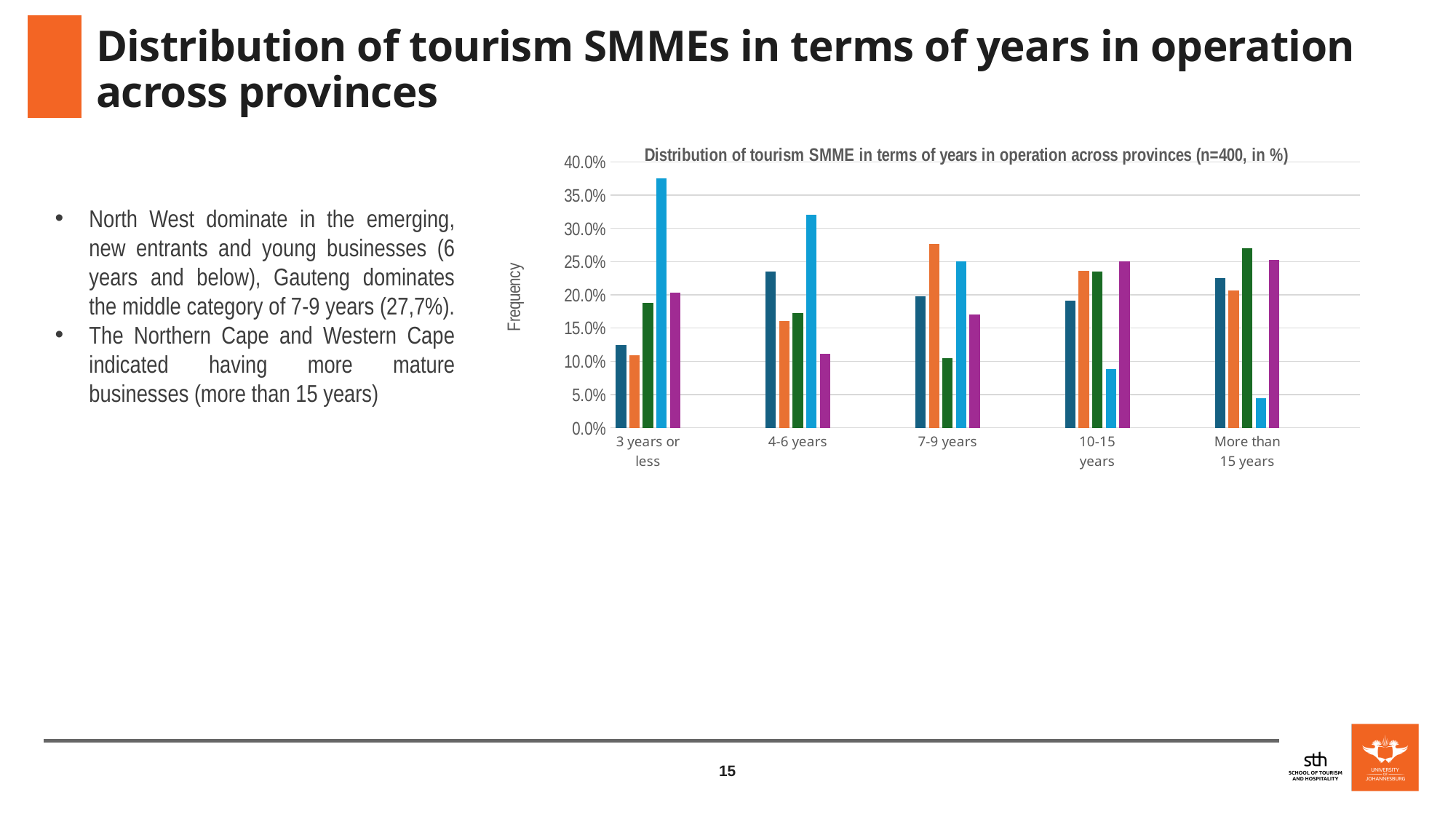
Is the value of the light blue bar for 'More than 15 years' greater or less than 5%? less What kind of chart is shown on the slide? bar chart What is the title of the chart? Distribution of tourism SMME in terms of years in operation across provinces (n=400, in %) Is the value of the dark green bar for '7-9 years' greater or less than 15%? less Is the value of the orange bar for '7-9 years' greater or less than 25%? greater How many year-in-operation categories are shown on the x axis of the chart? 5 In which category is the light blue bar the tallest? 3 years or less Do the light blue bars rise or fall as you move from '3 years or less' to 'More than 15 years'? fall In which category is the light blue bar the shortest? More than 15 years For the '4-6 years' category, which is larger: the light blue bar or the purple bar? the light blue bar What is the label on the vertical axis of the chart? Frequency